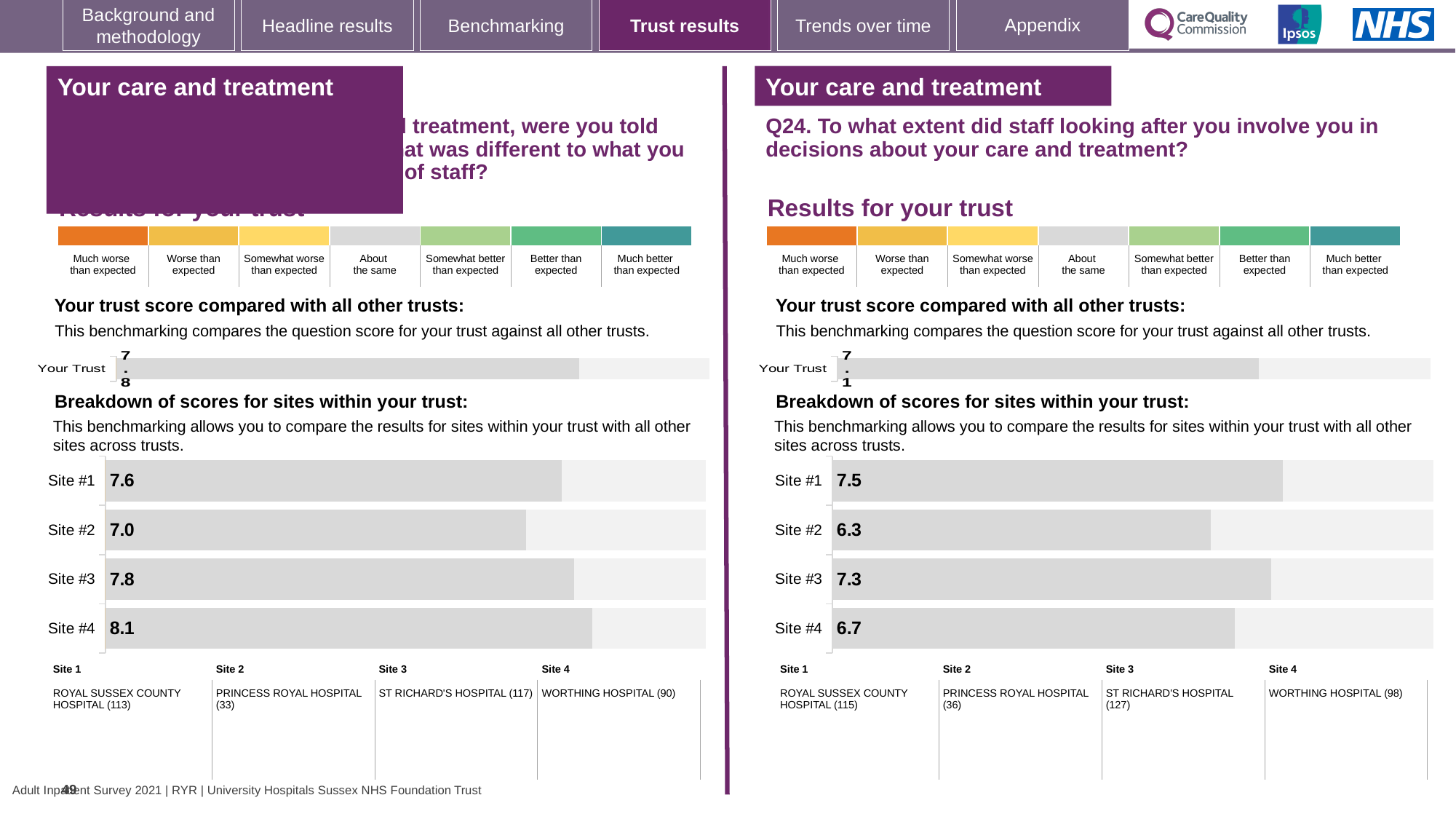
How many sites are shown on the right-hand (Q24) site breakdown chart? 4 On the right-hand (Q24) site breakdown chart, which has the higher score, Site #3 or Site #4? Site #3 On the right-hand (Q24) site breakdown chart, what is the score for Site #1? 7.5 On the left-hand 'Your Trust' chart, what is the trust score? 7.8 On the right-hand (Q24) site breakdown chart, what is the difference between the scores for Site #1 and Site #2? 1.2 On the right-hand (Q24) site breakdown chart, which site has the lowest score? Site #2 On the left-hand site breakdown chart, what is the difference between the scores for Site #4 and Site #2? 1.1 On the left-hand site breakdown chart, which has the higher score, Site #1 or Site #3? Site #3 What type of chart is used for the site breakdown on the left-hand side of the slide? Bar chart On the left-hand site breakdown chart, which site has the highest score? Site #4 On the left-hand site breakdown chart, what is the score for Site #4? 8.1 On the right-hand (Q24) 'Your Trust' chart, what is the trust score? 7.1